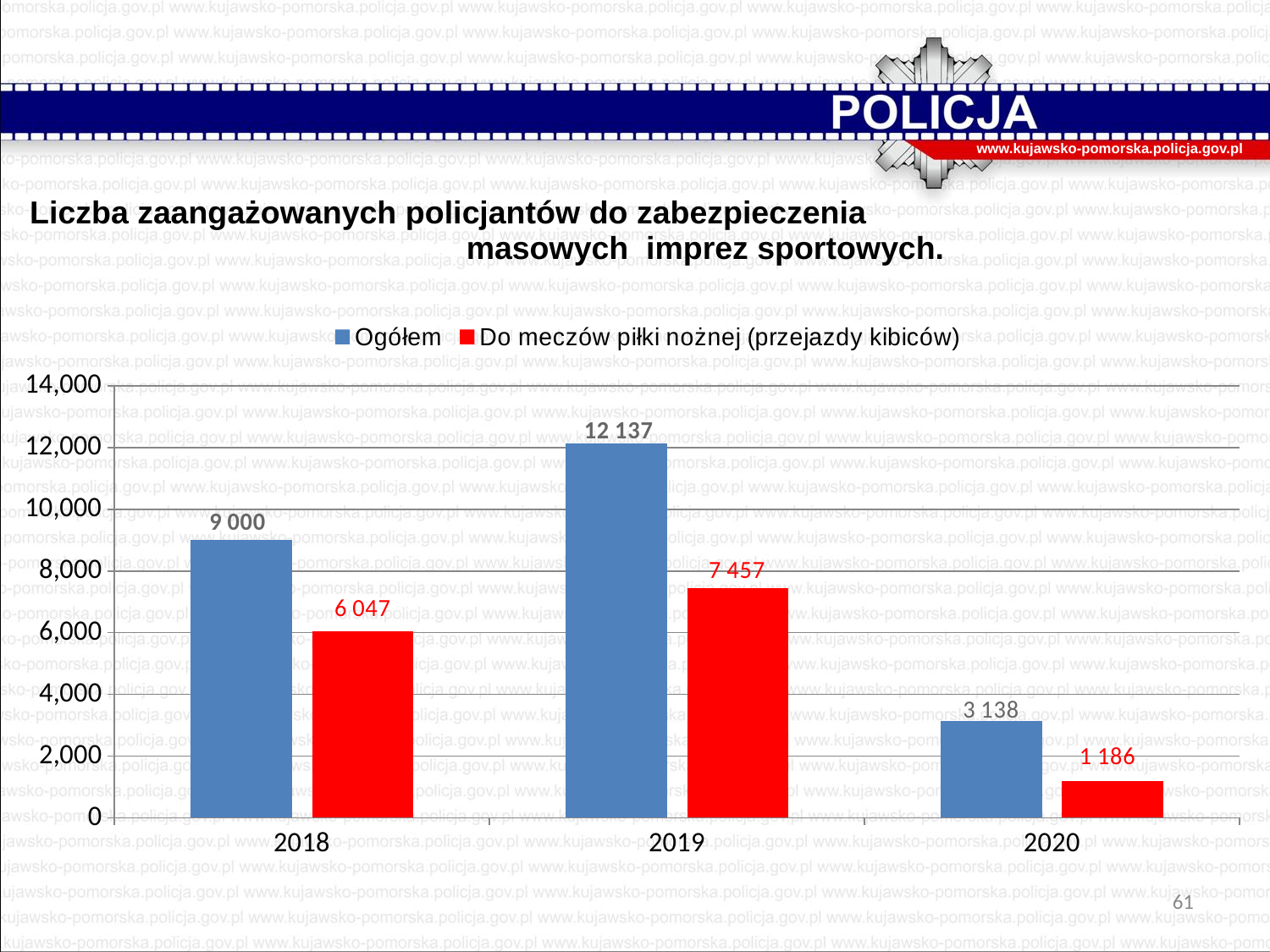
Which colour represents the Ogółem series? Blue What is the difference between the Ogółem values for 2018 and 2020? 5 862 In which year is the Ogółem value highest? 2019 What is the value for Ogółem in 2019? 12 137 How many series does the legend list? 2 What is the difference between the Ogółem and Do meczów piłki nożnej (przejazdy kibiców) values in 2019? 4 680 How many years are shown on the x axis? 3 In which year is the Do meczów piłki nożnej (przejazdy kibiców) value lowest? 2020 What is the value for Do meczów piłki nożnej (przejazdy kibiców) in 2020? 1 186 What kind of chart is shown on the slide? Bar chart What is the value for Ogółem in 2018? 9 000 Which is larger: the Do meczów piłki nożnej (przejazdy kibiców) value in 2018 or the Ogółem value in 2020? Do meczów piłki nożnej (przejazdy kibiców) in 2018